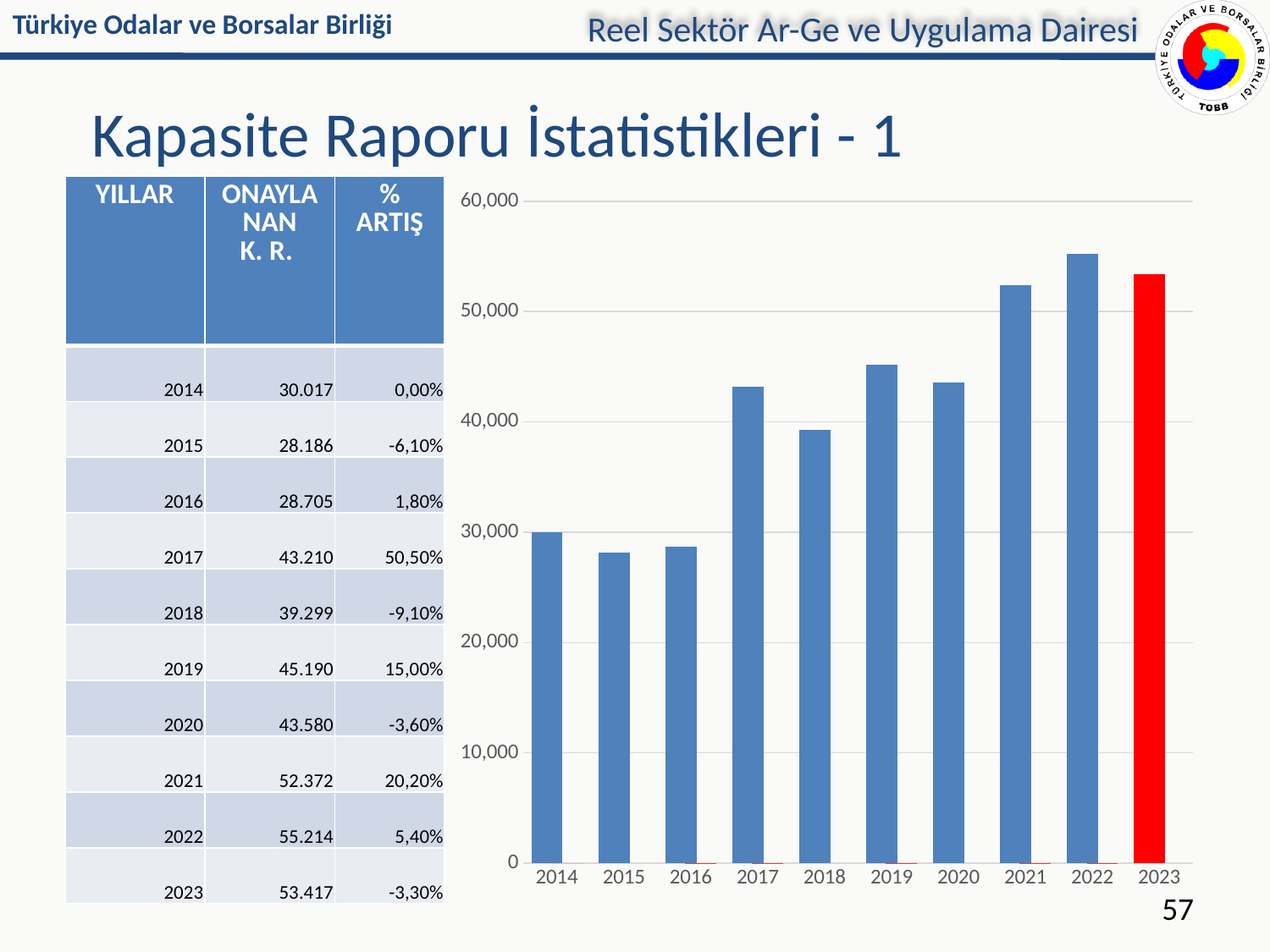
Is the value for 2021 greater or less than 50,000? greater What is the value of approved capacity reports (ONAYLANAN K. R.) for 2017? 43.210 Is the value for 2018 greater or less than 40,000? less What is the value of approved capacity reports (ONAYLANAN K. R.) for 2023? 53.417 Which year's bar is coloured red instead of blue? 2023 Which year has the larger value, 2017 or 2018? 2017 Which year has the lowest bar in the chart? 2015 How many years are plotted on the bar chart? 10 What is the difference between the values for 2022 and 2023? 1.797 Which year has the highest bar in the chart? 2022 Is the value for 2019 greater or less than 40,000? greater What kind of chart is shown on the slide? bar chart